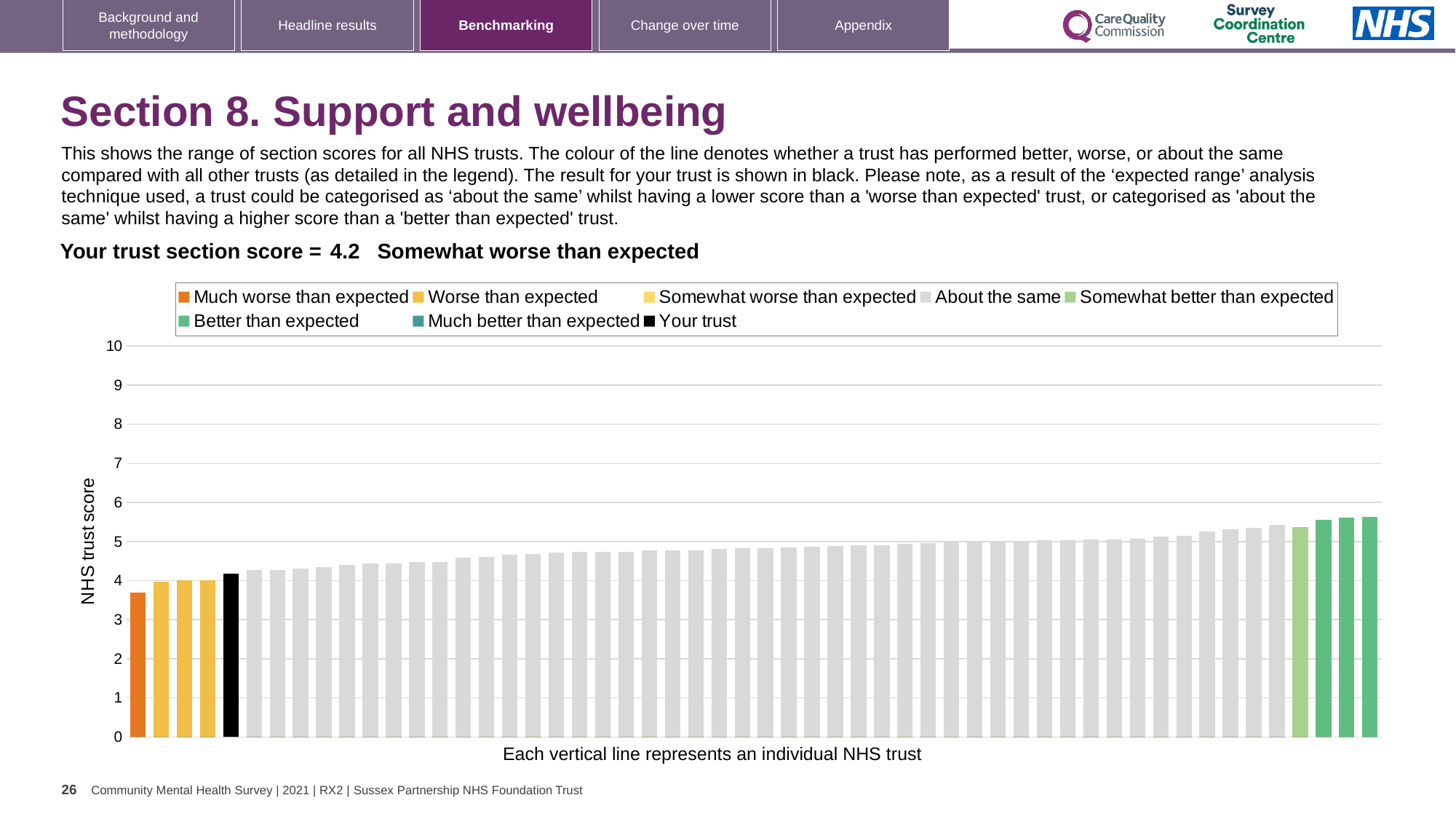
Is the value of the highest bar greater or less than 6? less Is the value of the highest bar greater or less than 5? greater How many entries does the chart legend list? 8 Which legend category does the lowest bar on the chart belong to? Much worse than expected Do the bar values rise or fall from left to right across the chart? rise What colour is the bar representing your trust? black What kind of chart is shown on the slide? bar chart What is the section score for your trust shown on the slide? 4.2 Which performance category is your trust placed in for Section 8? Somewhat worse than expected Is the value for your trust (black bar) greater or less than 5? less What is the label on the vertical axis of the chart? NHS trust score